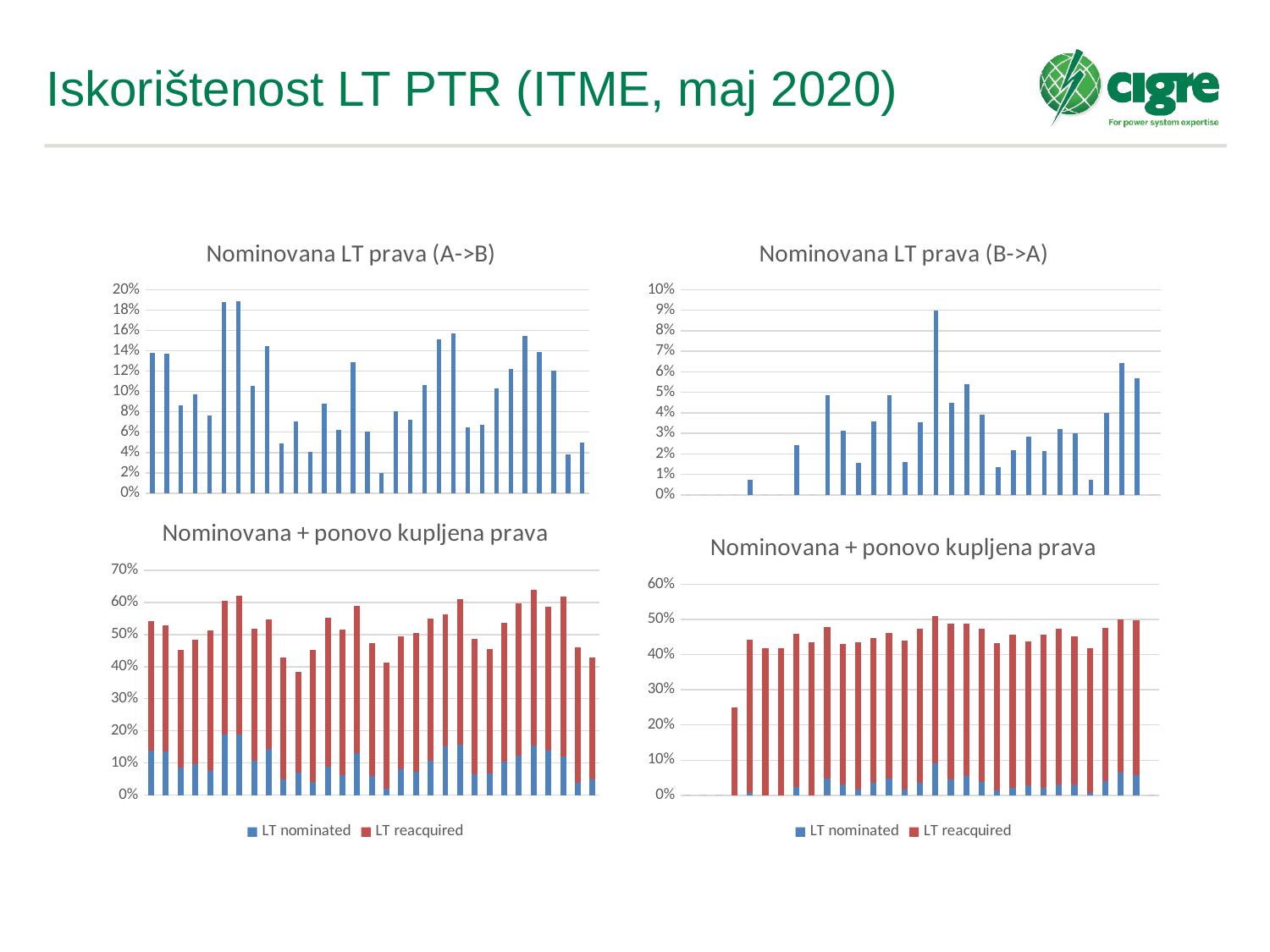
In the bottom-right chart, which colour represents the "LT reacquired" series? red What kind of chart is the top-left chart titled "Nominovana LT prava (A->B)"? bar chart How many series does the legend list in the bottom-right chart titled "Nominovana + ponovo kupljena prava"? 2 How many series does the legend list in the bottom-left chart titled "Nominovana + ponovo kupljena prava"? 2 In the top-right chart "Nominovana LT prava (B->A)", is the tallest bar greater or less than 10%? less In the bottom-left chart "Nominovana + ponovo kupljena prava", is the tallest stacked bar greater or less than 60%? greater In the bottom-right chart "Nominovana + ponovo kupljena prava", is the shortest stacked bar greater or less than 30%? less What are the two series named in the legend of the bottom-left chart? LT nominated, LT reacquired What kind of chart is the bottom-left chart titled "Nominovana + ponovo kupljena prava"? stacked bar chart